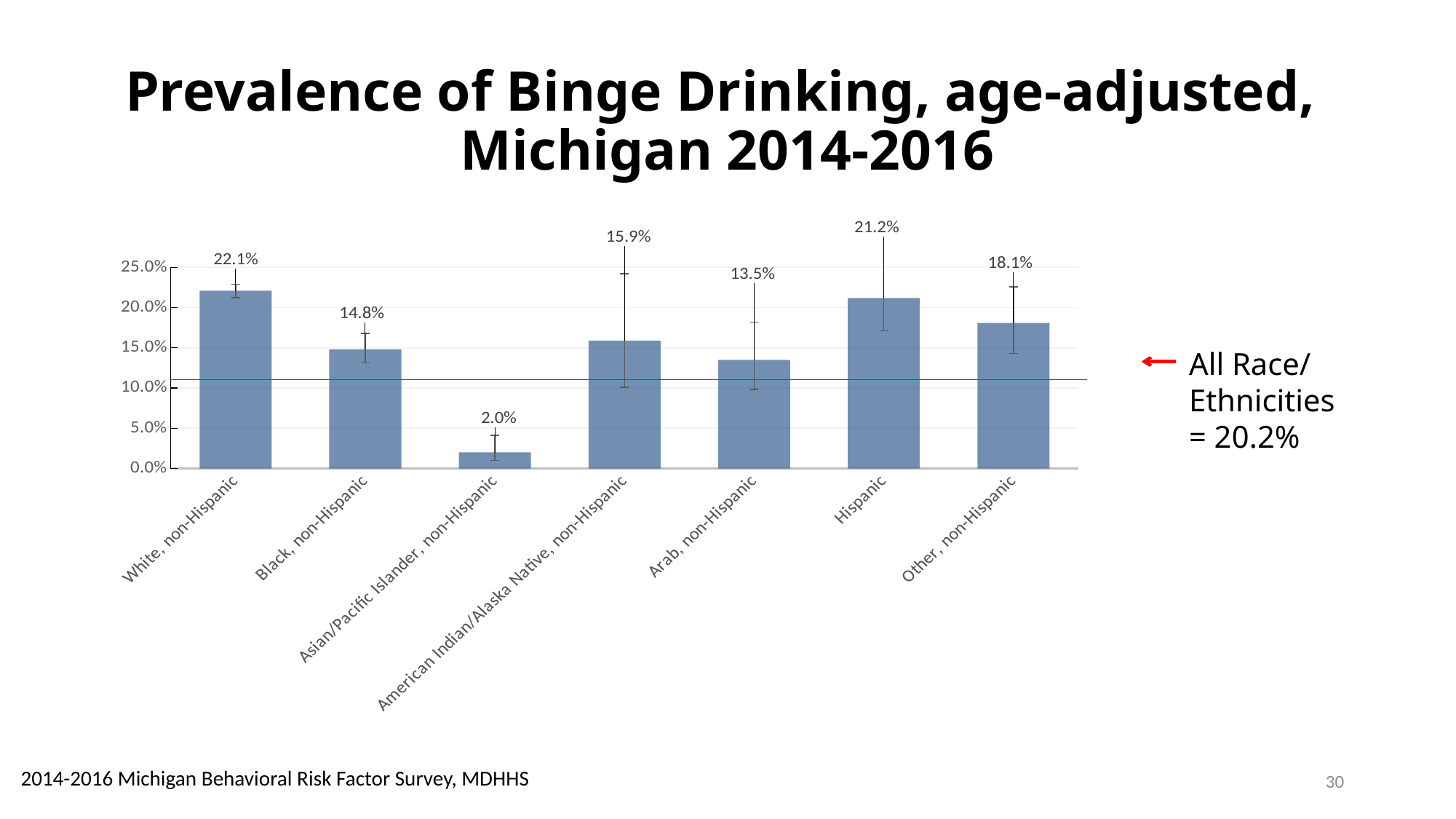
What is the prevalence of binge drinking for Hispanic? 21.2% Which race/ethnicity group has the lowest prevalence of binge drinking? Asian/Pacific Islander, non-Hispanic What is the difference in binge drinking prevalence between White, non-Hispanic and Black, non-Hispanic? 7.3% Which has a higher prevalence of binge drinking: American Indian/Alaska Native, non-Hispanic or Other, non-Hispanic? Other, non-Hispanic What is the binge drinking prevalence for all race/ethnicities combined, as noted beside the chart? 20.2% How many race/ethnicity categories are shown in the chart? 7 What is the prevalence of binge drinking for Arab, non-Hispanic? 13.5% Which race/ethnicity group has the highest prevalence of binge drinking? White, non-Hispanic What is the prevalence of binge drinking for Asian/Pacific Islander, non-Hispanic? 2.0% What is the prevalence of binge drinking for White, non-Hispanic? 22.1% What kind of chart is shown on the slide? Bar chart Is the value for Black, non-Hispanic greater or less than 10.0%? greater